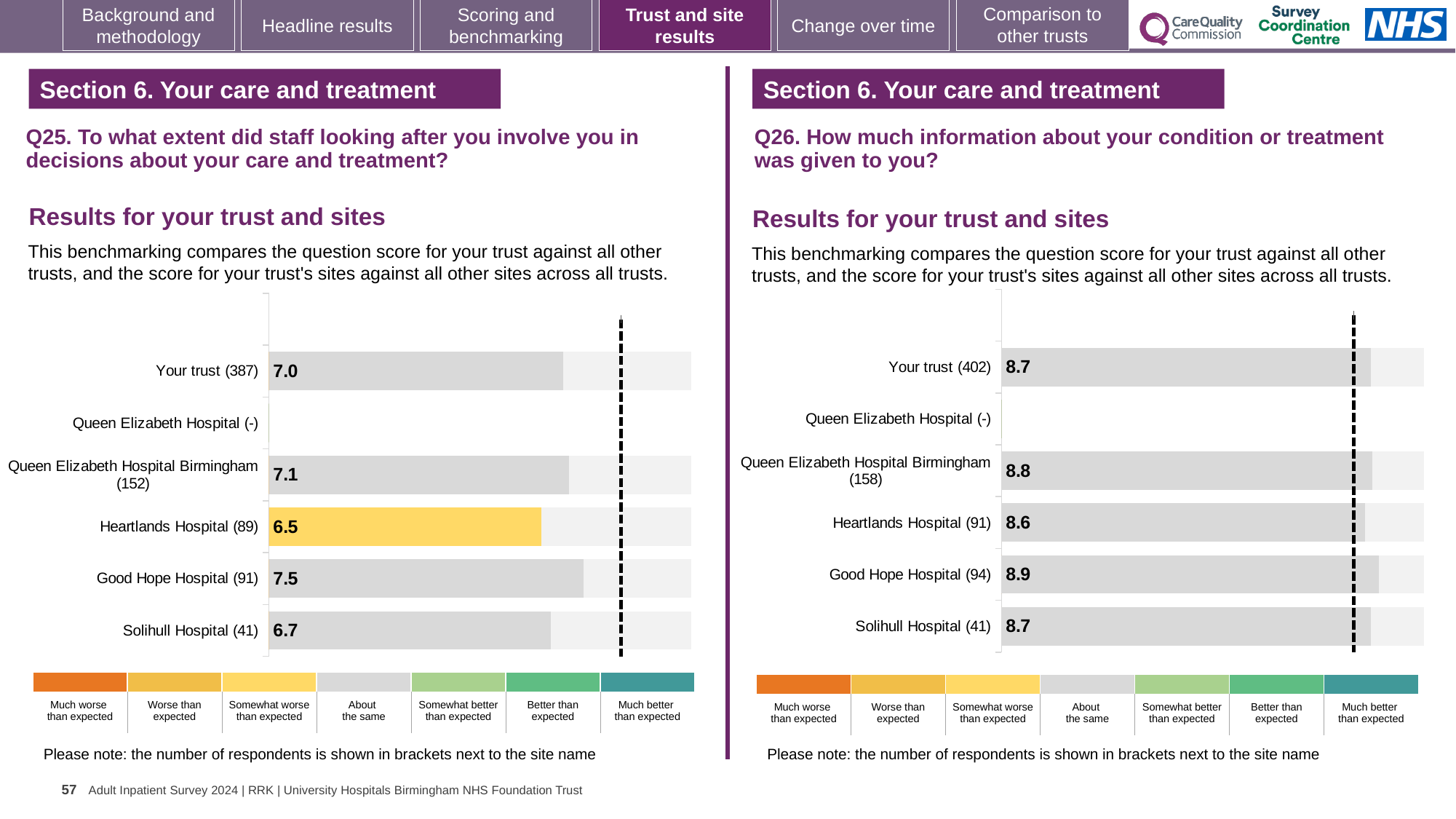
In the Q25 chart on the left, what is the difference between the scores for Good Hope Hospital (91) and Heartlands Hospital (89)? 1.0 In the Q25 chart on the left, what is the score for Good Hope Hospital (91)? 7.5 In the Q25 chart on the left, which has the higher score: Your trust (387) or Solihull Hospital (41)? Your trust (387) In the Q25 chart on the left, what is the score for Heartlands Hospital (89)? 6.5 In the Q25 chart on the left, which site has the highest score? Good Hope Hospital (91) In the Q26 chart on the right, which site has the highest score? Good Hope Hospital (94) In the Q26 chart on the right, what is the difference between the scores for Good Hope Hospital (94) and Heartlands Hospital (91)? 0.3 In the Q26 chart on the right, what is the score for Queen Elizabeth Hospital Birmingham (158)? 8.8 In the Q25 chart on the left, which site's bar is coloured yellow rather than grey? Heartlands Hospital (89) In the Q26 chart on the right, what is the score for Your trust (402)? 8.7 What kind of chart is used in the Q26 chart on the right? Bar chart In the Q25 chart on the left, which site has the lowest score? Heartlands Hospital (89)